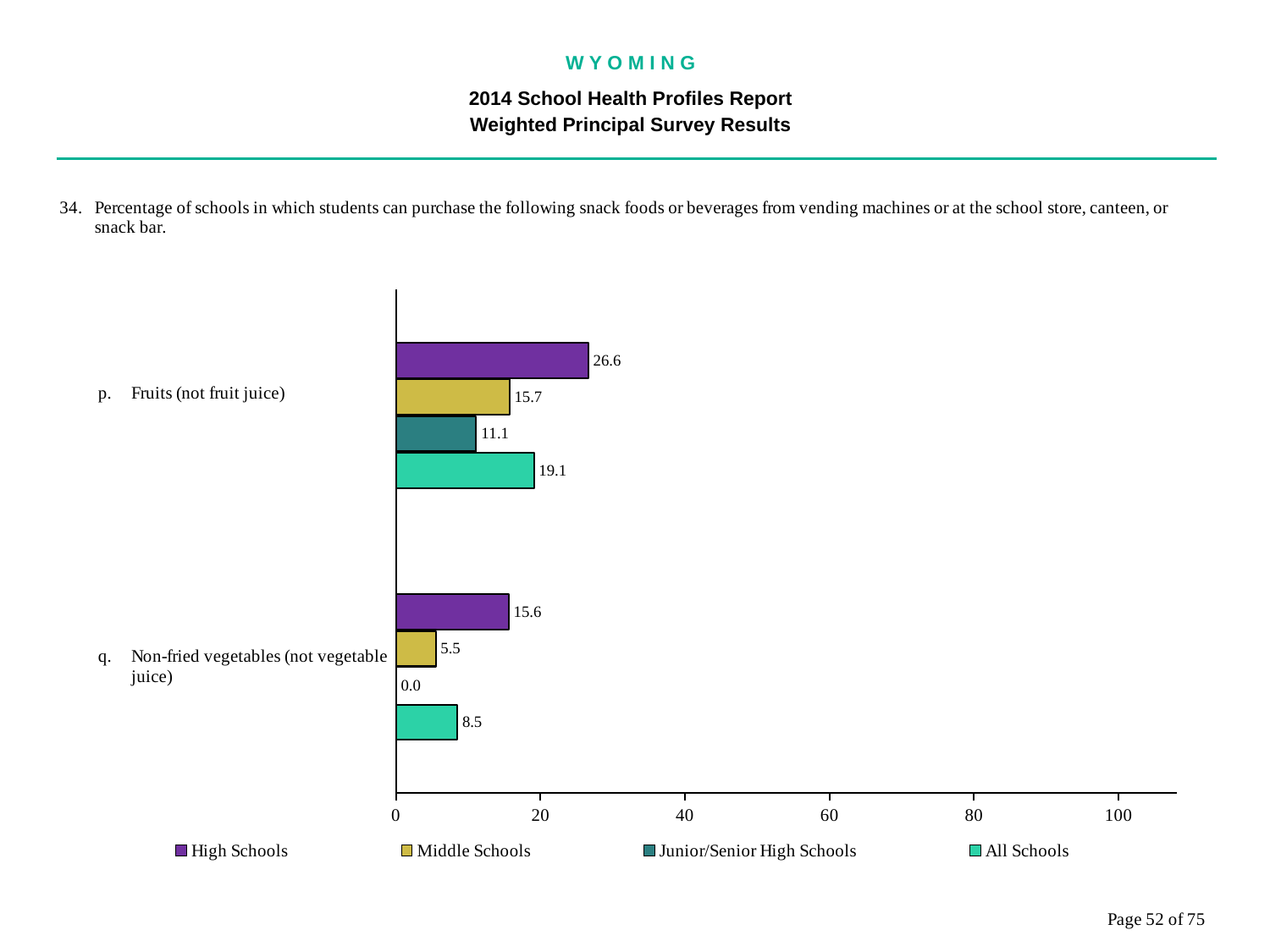
What is the value for All Schools for Fruits (not fruit juice)? 19.1 What kind of chart is shown on the slide? bar chart What is the value for Junior/Senior High Schools for Non-fried vegetables (not vegetable juice)? 0.0 What is the difference between the High Schools values for Fruits (not fruit juice) and Non-fried vegetables (not vegetable juice)? 11.0 How many snack food categories are plotted on the chart? 2 What is the value for High Schools for Fruits (not fruit juice)? 26.6 Which is larger: the All Schools value for Fruits (not fruit juice) or the Middle Schools value for Fruits (not fruit juice)? All Schools value for Fruits (not fruit juice) Which school type has the lowest value for Non-fried vegetables (not vegetable juice)? Junior/Senior High Schools Which school type has the highest value for Fruits (not fruit juice)? High Schools Is the value for High Schools for Fruits (not fruit juice) greater or less than 20? greater How many series does the legend list? 4 What is the value for Middle Schools for Non-fried vegetables (not vegetable juice)? 5.5